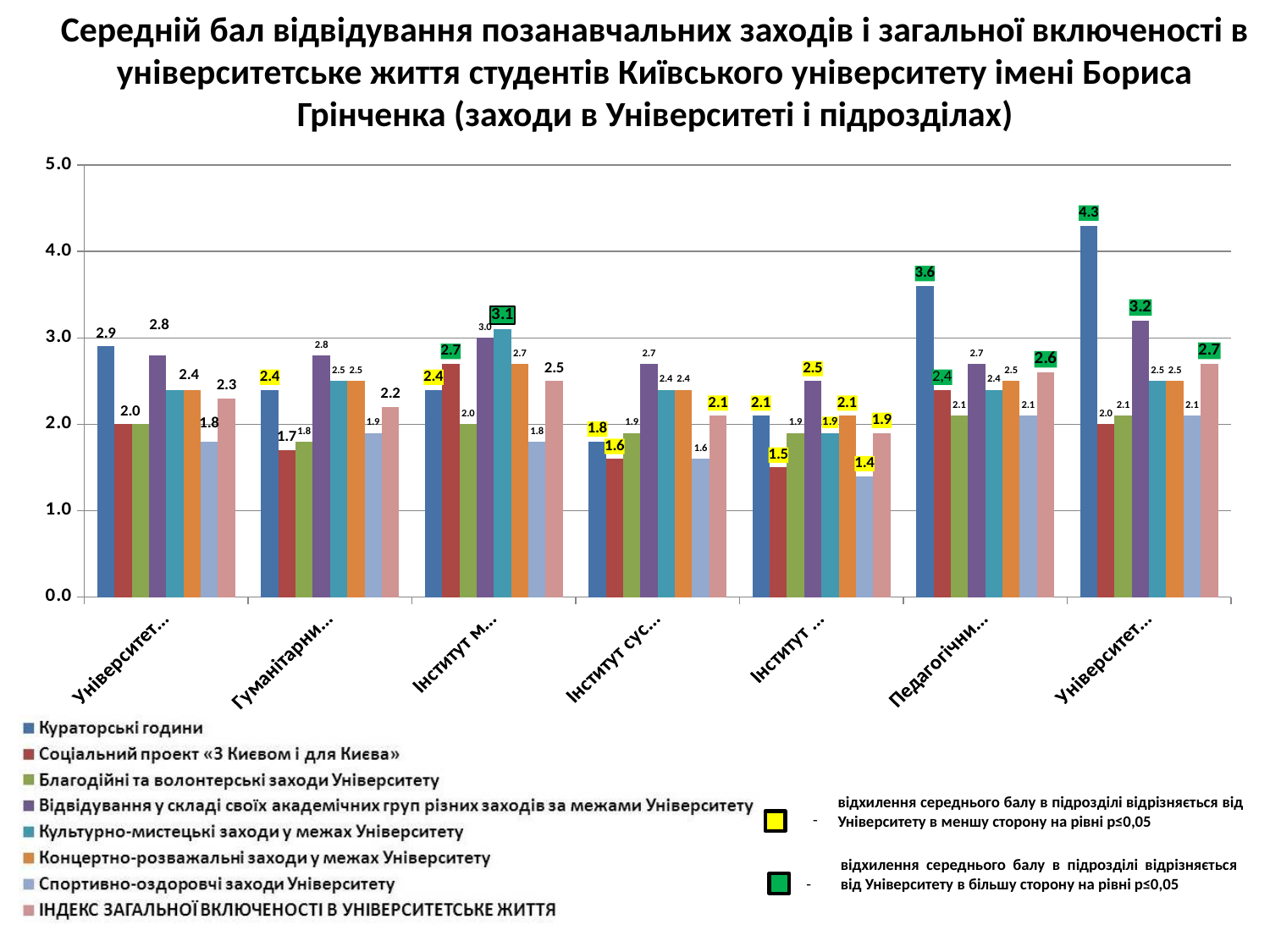
In the last (rightmost) group, what is the difference between Кураторські години and Соціальний проект «З Києвом і для Києва»? 2.3 What kind of chart is shown on the slide? bar chart In the first (leftmost) group, what is the value for Кураторські години? 2.9 What is the highest value shown on the chart? 4.3 How many series does the legend list? 8 What is the lowest value shown on the chart? 1.4 Which series is shown in dark blue in the legend? Кураторські години In the third group (Інститут м...), what is the value for Культурно-мистецькі заходи у межах Університету? 3.1 How many category groups are plotted along the x axis? 7 In the sixth group (Педагогічни...), which is larger: Кураторські години or ІНДЕКС ЗАГАЛЬНОЇ ВКЛЮЧЕНОСТІ В УНІВЕРСИТЕТСЬКЕ ЖИТТЯ? Кураторські години Is the value for Кураторські години in the last (rightmost) group greater or less than 4.0? greater In the last (rightmost) group, what is the value for Відвідування у складі своїх академічних груп різних заходів за межами Університету? 3.2